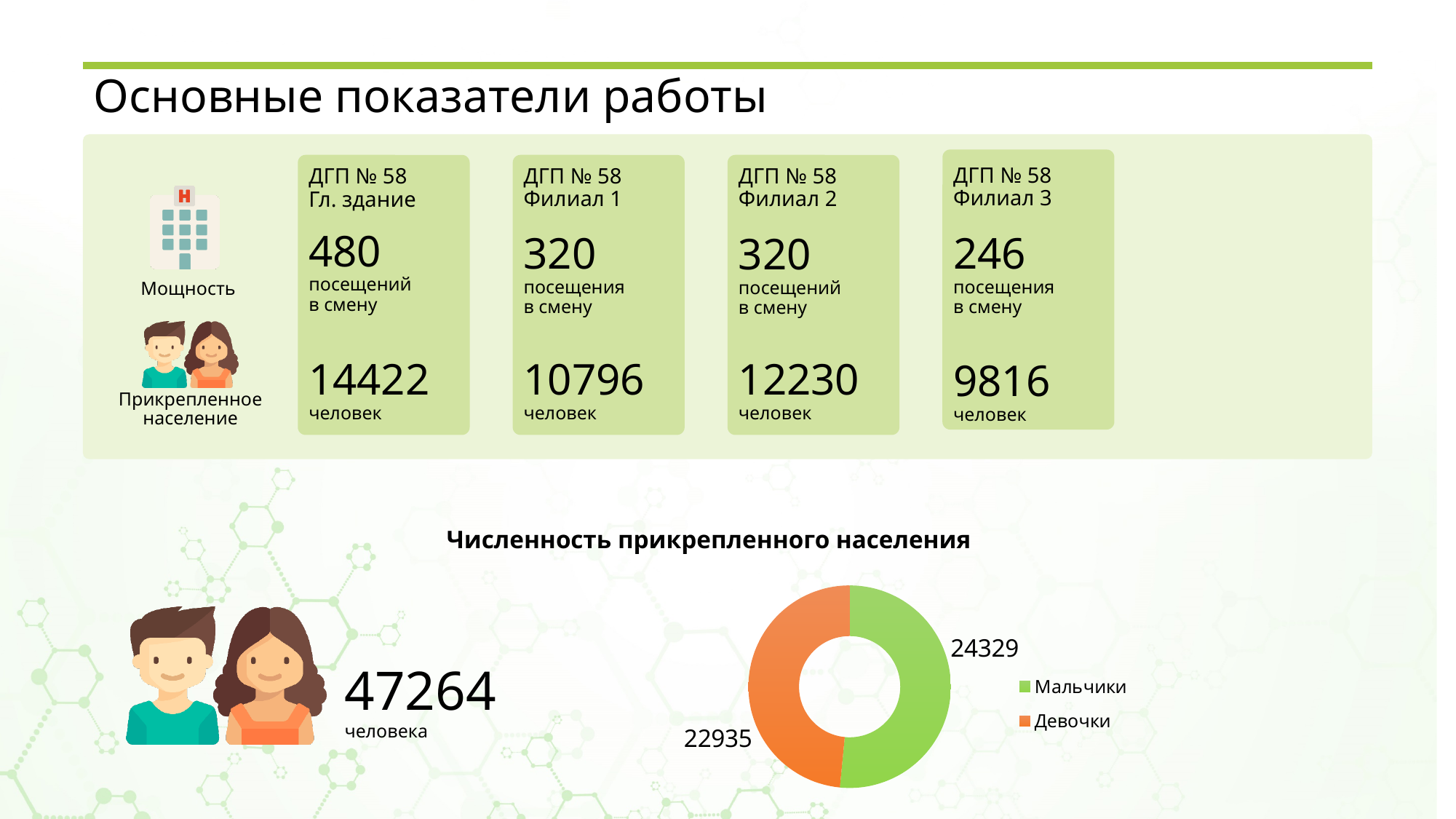
What is the value for Девочки in the chart "Численность прикрепленного населения"? 22935 What is the value for Мальчики in the chart "Численность прикрепленного населения"? 24329 In the chart "Численность прикрепленного населения", which is larger: Мальчики or Девочки? Мальчики How many categories does the chart "Численность прикрепленного населения" show? 2 Which category has the largest slice in the chart "Численность прикрепленного населения"? Мальчики What is the title of the doughnut chart on the slide? Численность прикрепленного населения Which category has the smallest slice in the chart "Численность прикрепленного населения"? Девочки What colour represents Девочки in the chart "Численность прикрепленного населения"? Orange What kind of chart is shown under the title "Численность прикрепленного населения"? Doughnut (pie) chart How many entries does the legend of the chart "Численность прикрепленного населения" list? 2 In the chart "Численность прикрепленного населения", what is the difference between the values for Мальчики and Девочки? 1394 What is the total of the two slices in the chart "Численность прикрепленного населения"? 47264